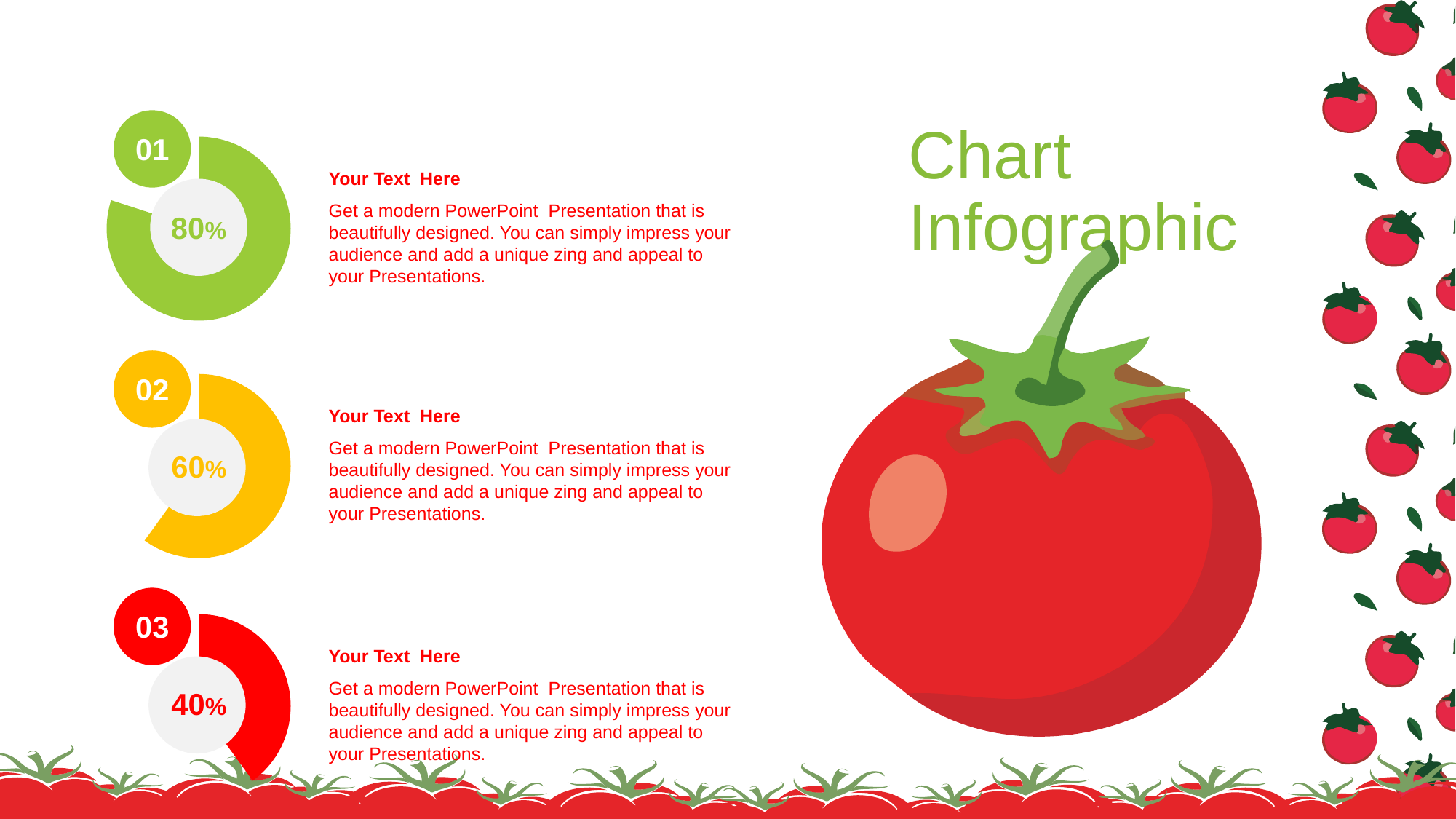
What colour is the chart labelled 02? yellow What is the difference between the value in chart 02 and the value in chart 03? 20% What value is shown in the chart labelled 02? 60% What is the title text on the slide? Chart Infographic What kind of chart is used to show the percentages on the left of the slide? donut chart How many numbered percentage charts are on the slide? 3 Which of the three numbered charts shows the lowest percentage? 03 What value is shown in the chart labelled 03? 40% What value is shown in the chart labelled 01? 80% Which of the three numbered charts shows the highest percentage? 01 Which is larger, the value in chart 02 or the value in chart 03? chart 02 What is the difference between the value in chart 01 and the value in chart 03? 40%